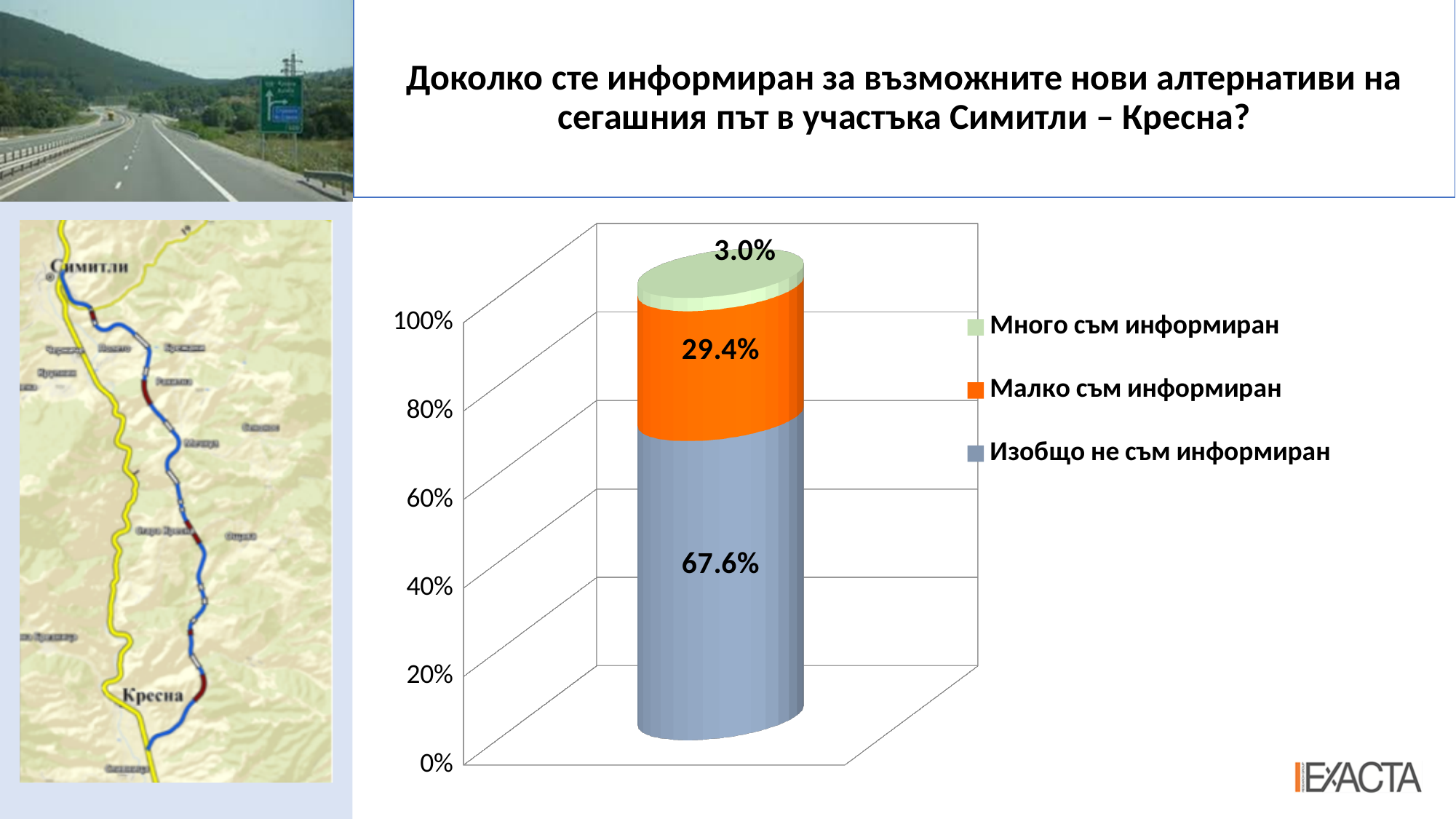
What colour is the segment for "Малко съм информиран"? Orange Which is larger: the share for "Малко съм информиран" or the share for "Много съм информиран"? Малко съм информиран What percentage of respondents answered "Изобщо не съм информиран"? 67.6% Which response has the largest share in the chart? Изобщо не съм информиран How many series does the legend list? 3 What is the difference in percentage points between "Малко съм информиран" and "Много съм информиран"? 26.4 What kind of chart is shown on the slide? Stacked bar chart What percentage of respondents answered "Много съм информиран"? 3.0% What percentage of respondents answered "Малко съм информиран"? 29.4% What is the total of the three segments in the stacked bar? 100.0% What is the difference in percentage points between "Изобщо не съм информиран" and "Малко съм информиран"? 38.2 Which response has the smallest share in the chart? Много съм информиран